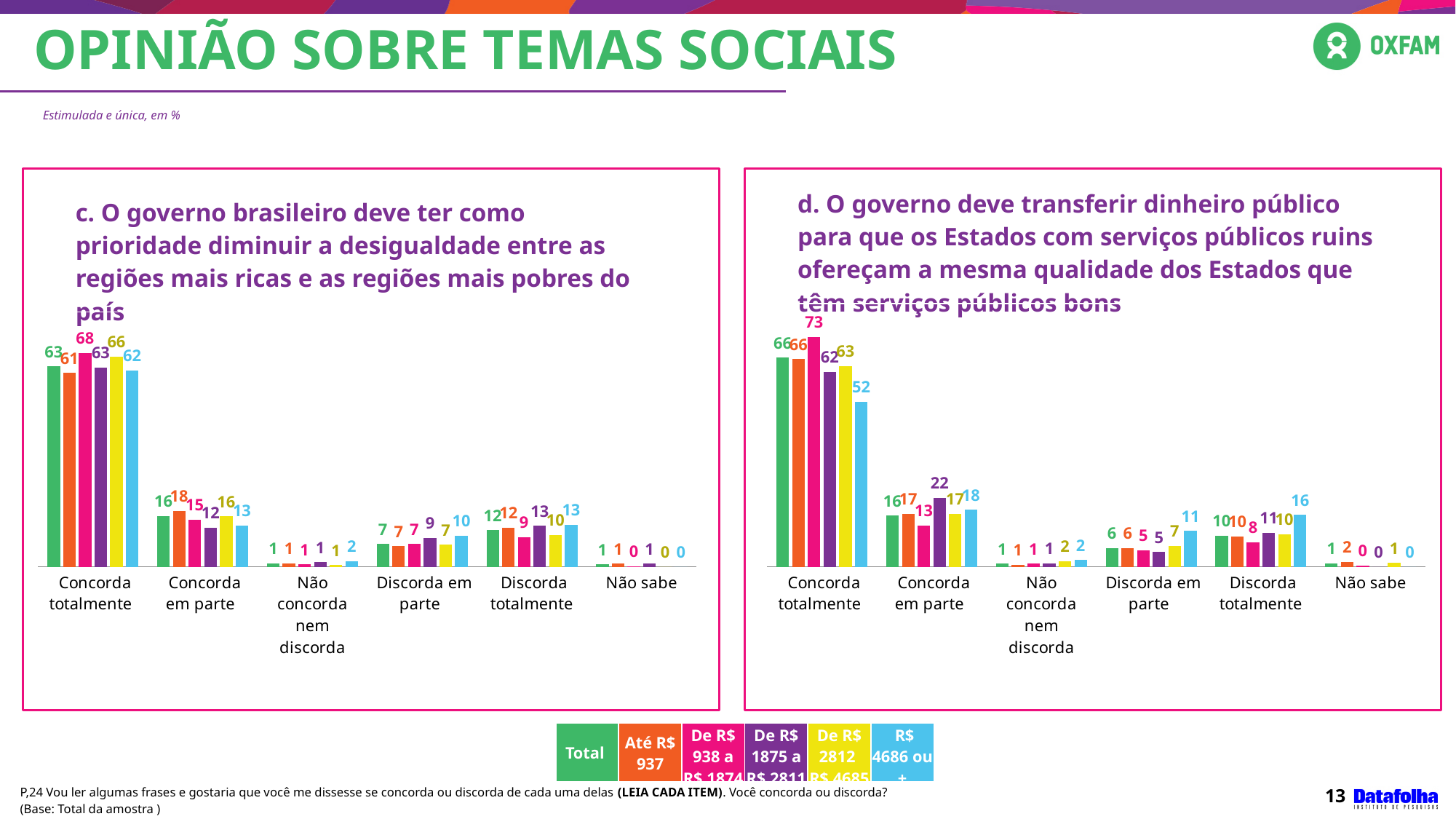
What type of chart is the right chart (d.)? Bar chart In the right chart (d.), which income group has the highest value for 'Concorda totalmente'? De R$ 938 a R$ 1874 Which colour represents the 'Total' series in the legend? Green In the left chart (c. O governo brasileiro deve ter como prioridade diminuir a desigualdade...), what is the Total value for 'Concorda totalmente'? 63 In the right chart (d.), what is the value for 'Até R$ 937' in 'Discorda totalmente'? 10 In the right chart (d.), what is the difference between the Total values for 'Concorda totalmente' and 'Concorda em parte'? 50 In the left chart (c.), which is larger for 'Discorda em parte': the value for 'R$ 4686 ou +' or the Total value? R$ 4686 ou + In the left chart (c.), which response category has the lowest Total value? Não concorda nem discorda (tied with Não sabe, both 1) How many series does the legend at the bottom of the slide list? 6 How many response categories are shown on the x axis of the left chart (c.)? 6 In the right chart (d.), what is the value for 'R$ 4686 ou +' in 'Discorda totalmente'? 16 In the right chart (d. O governo deve transferir dinheiro público...), what is the value for 'R$ 4686 ou +' in 'Concorda totalmente'? 52